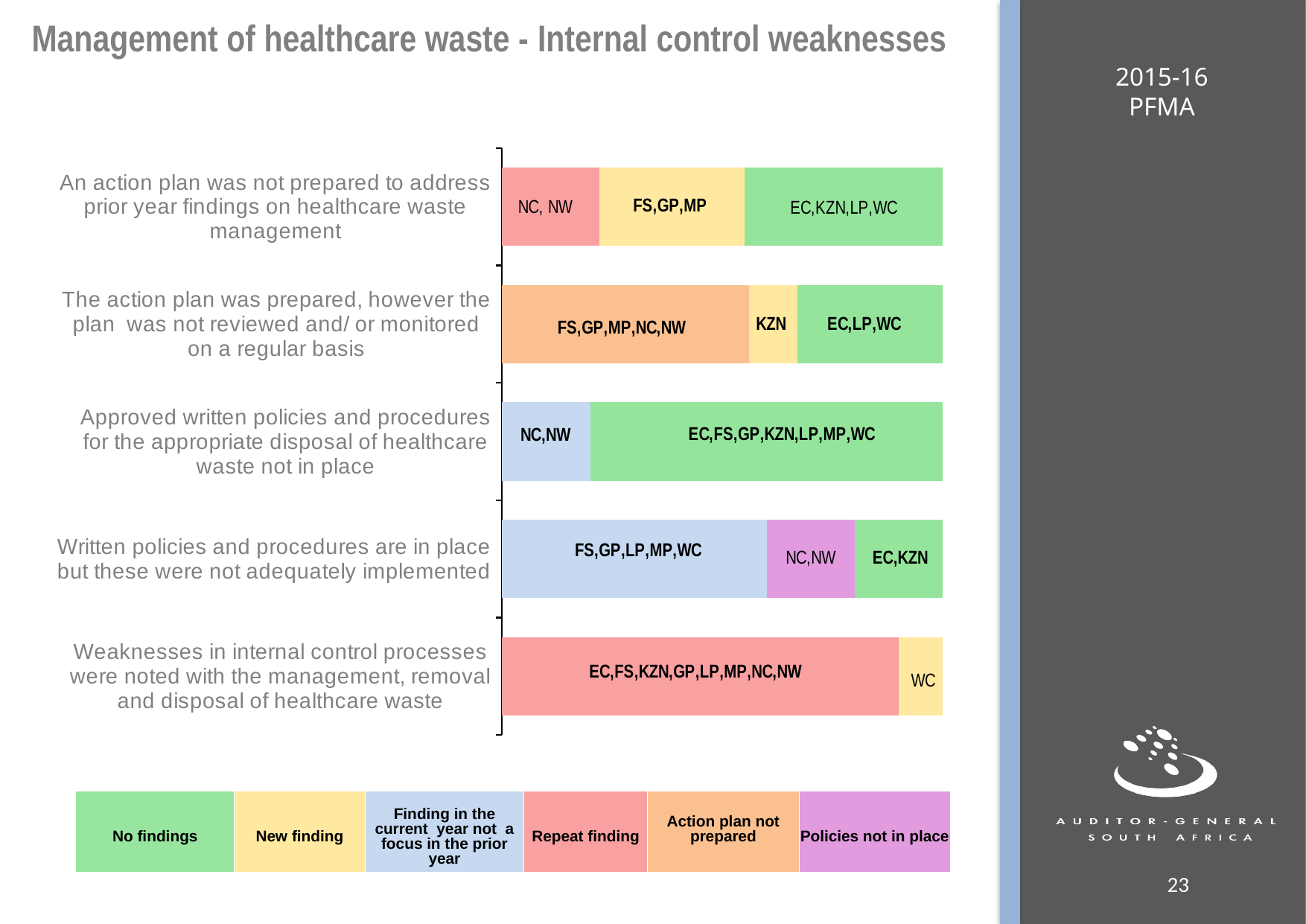
Which provinces are shown in the 'New finding' segment for 'An action plan was not prepared to address prior year findings on healthcare waste management'? FS,GP,MP Which provinces are shown in the 'Policies not in place' segment for 'Written policies and procedures are in place but these were not adequately implemented'? NC,NW Which provinces are shown in the 'No findings' segment for 'An action plan was not prepared to address prior year findings on healthcare waste management'? EC,KZN,LP,WC How many categories (internal control weaknesses) are plotted on the chart? 5 What kind of chart is shown on the slide? Stacked bar chart Which province is shown in the 'New finding' segment for 'The action plan was prepared, however the plan was not reviewed and/ or monitored on a regular basis'? KZN What colour represents 'Repeat finding' in the legend? Red Which provinces are shown in the 'Action plan not prepared' segment for 'The action plan was prepared, however the plan was not reviewed and/ or monitored on a regular basis'? FS,GP,MP,NC,NW Which provinces are shown in the 'No findings' segment for 'Approved written policies and procedures for the appropriate disposal of healthcare waste not in place'? EC,FS,GP,KZN,LP,MP,WC Which category has the largest 'No findings' segment? Approved written policies and procedures for the appropriate disposal of healthcare waste not in place How many entries does the legend at the bottom of the chart list? 6 Which province is shown in the 'New finding' segment for 'Weaknesses in internal control processes were noted with the management, removal and disposal of healthcare waste'? WC